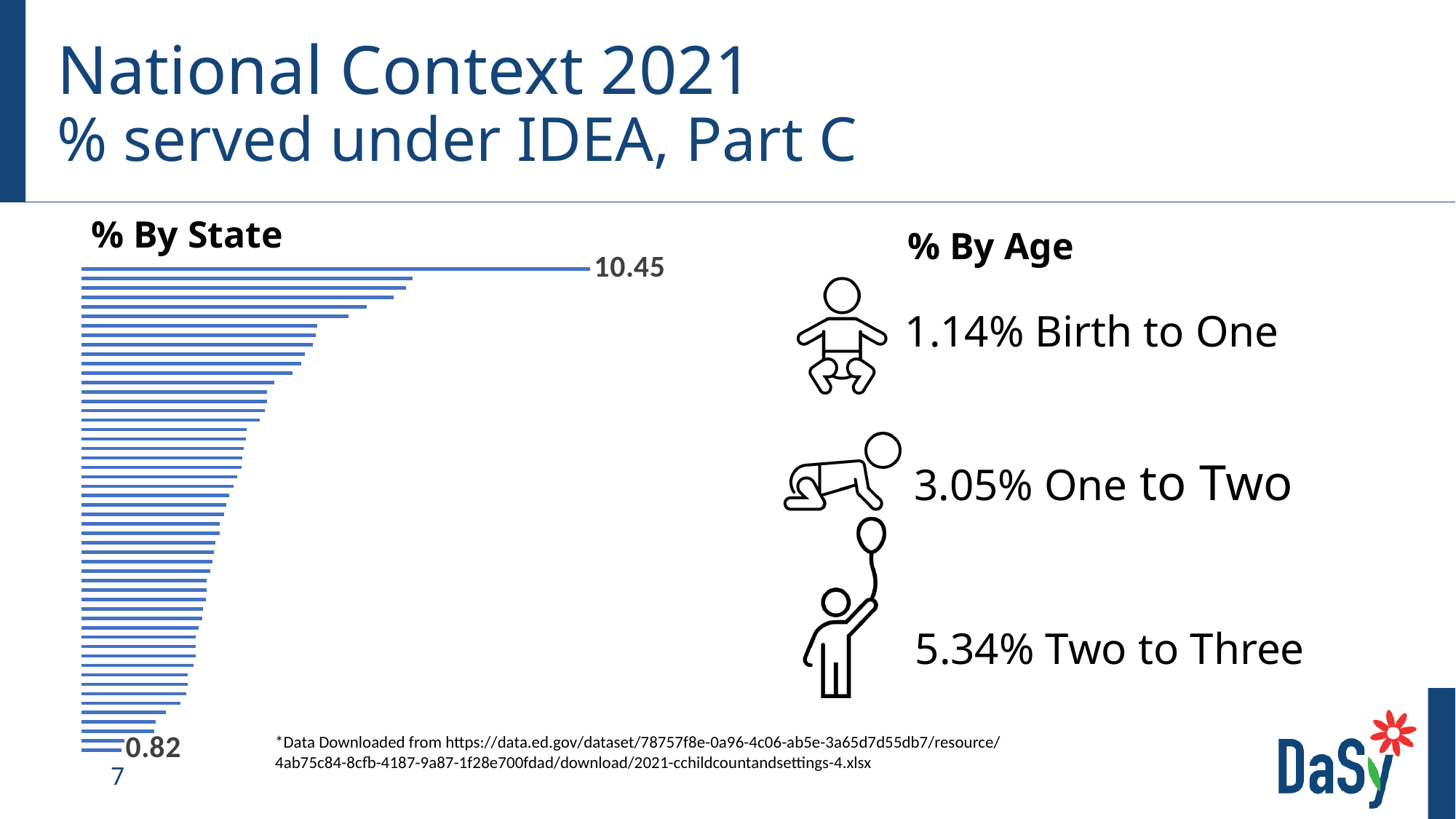
In the "% By State" chart, what is the value of the longest bar? 10.45 In the "% By State" chart, do the bar lengths increase or decrease going from the top bar to the bottom bar? decrease What is the title of the chart on the left of the slide? % By State In the "% By State" chart, how many bars have a printed data label? 2 What kind of chart is the "% By State" chart? bar chart In the "% By State" chart, which is larger: the value of the top bar or the value of the bottom bar? the top bar In the "% By State" chart, what is the value of the shortest bar? 0.82 In the "% By State" chart, where is the bar labelled 10.45 positioned: at the top or at the bottom of the chart? at the top In the "% By State" chart, what is the difference between the highest labelled value and the lowest labelled value? 9.63